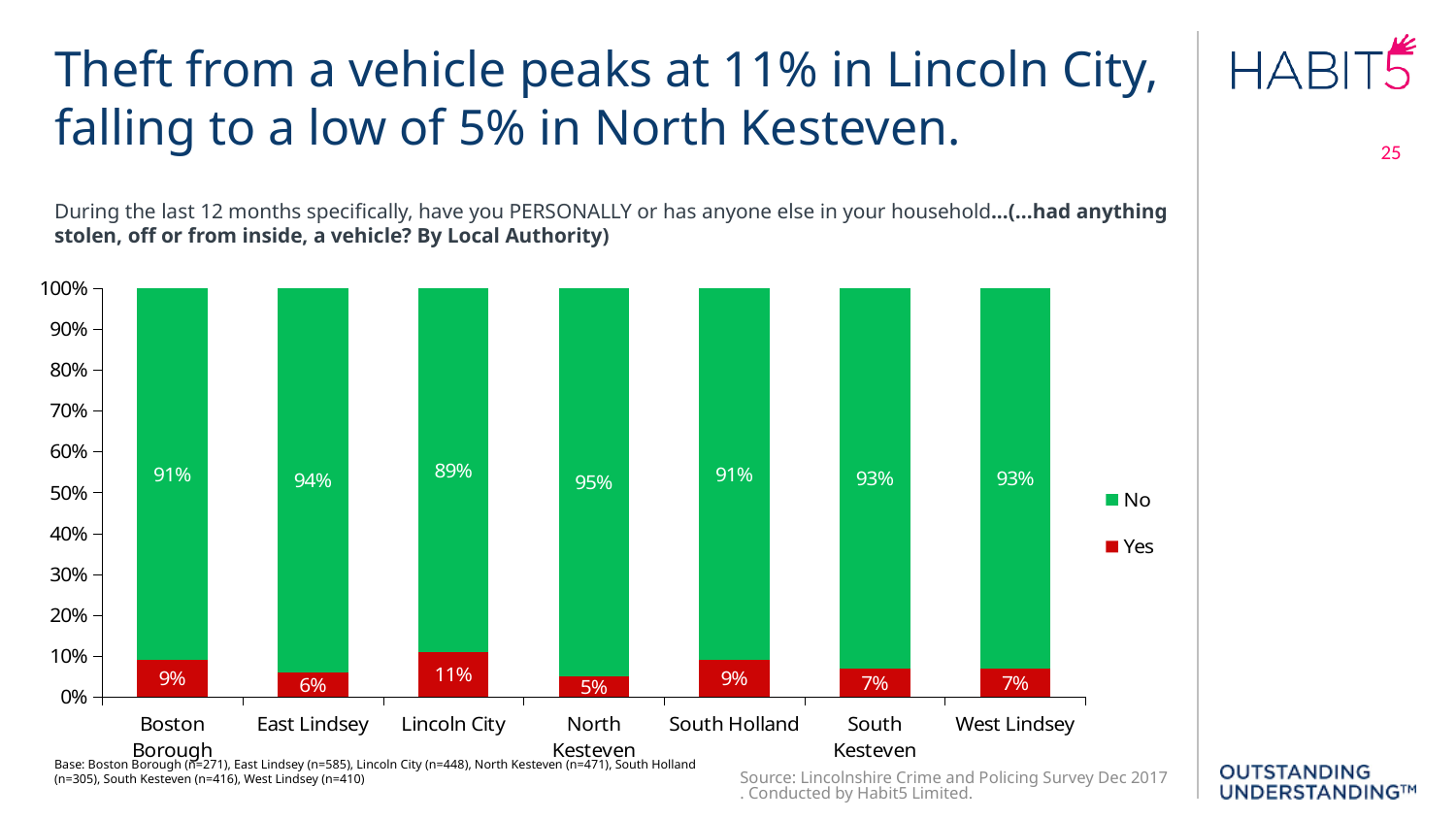
Which colour represents the Yes responses in the chart? Red What is the difference between the Yes percentages for Lincoln City and North Kesteven? 6 percentage points Which local authority has the lowest Yes percentage? North Kesteven How many local authorities are shown on the x axis? 7 Which local authority has the highest Yes percentage? Lincoln City How many series does the legend list? 2 What percentage of respondents in Lincoln City answered Yes? 11% What is the Yes value for South Holland? 9% What kind of chart is shown on the slide? Stacked bar chart What percentage of respondents in East Lindsey answered No? 94% What is the total of the stacked bar for South Kesteven? 100% Which has a higher Yes percentage, Boston Borough or East Lindsey? Boston Borough